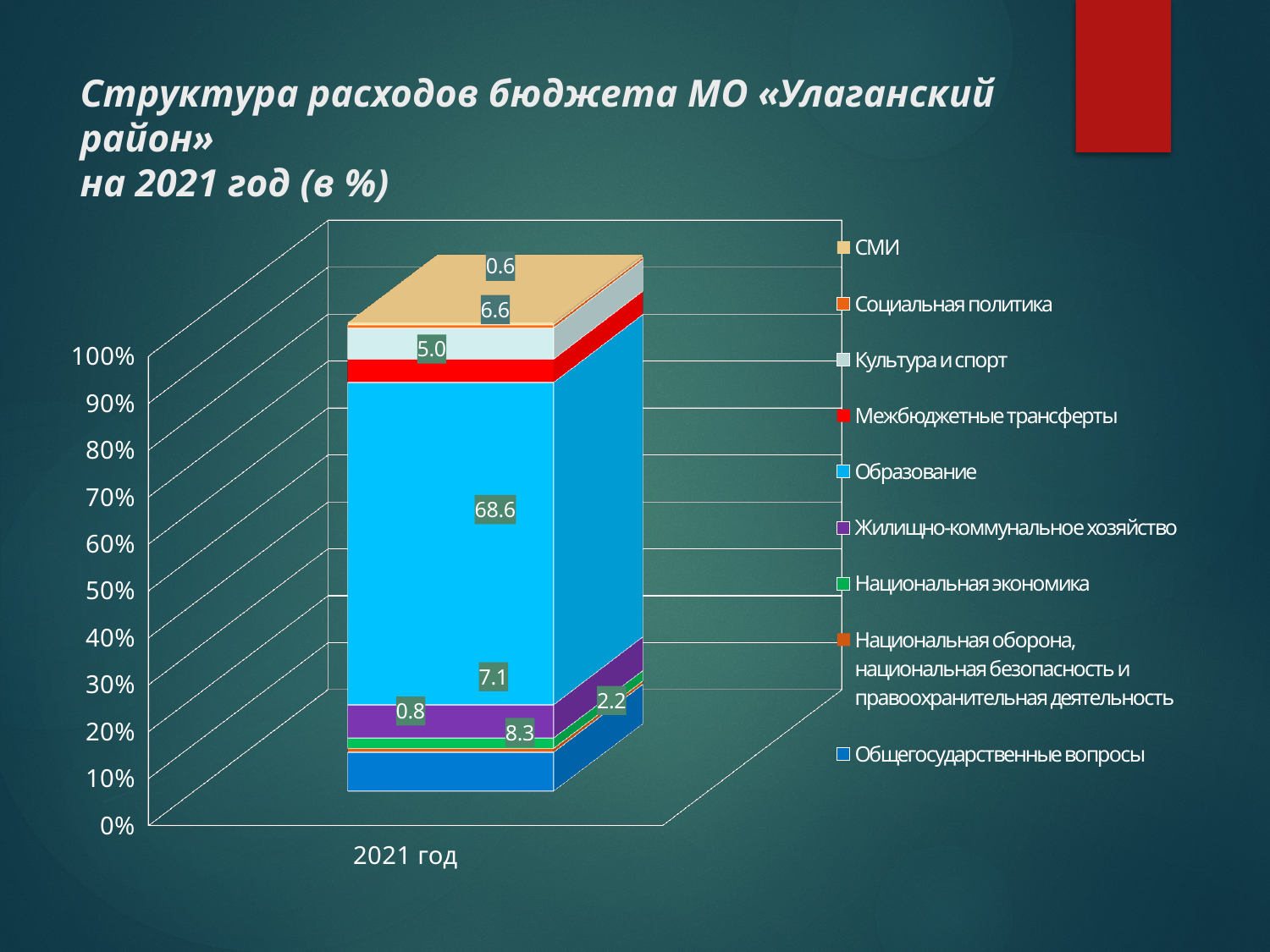
How many series does the legend list? 9 What is the value shown for Образование? 68.6 What is the smallest data label shown on the bar? 0.6 Which series has the largest share of the stacked bar? Образование How many categories are shown on the x axis? 1 Is the value for Образование greater or less than 60? greater Which is larger, the share for Образование or the share for Общегосударственные вопросы? Образование What kind of chart is shown on the slide? Stacked bar chart What is the largest data label shown on the bar? 68.6 What is the difference between the largest and smallest data labels on the bar? 68.0 Which legend entry is listed first (at the top)? СМИ What is the category label on the x axis? 2021 год